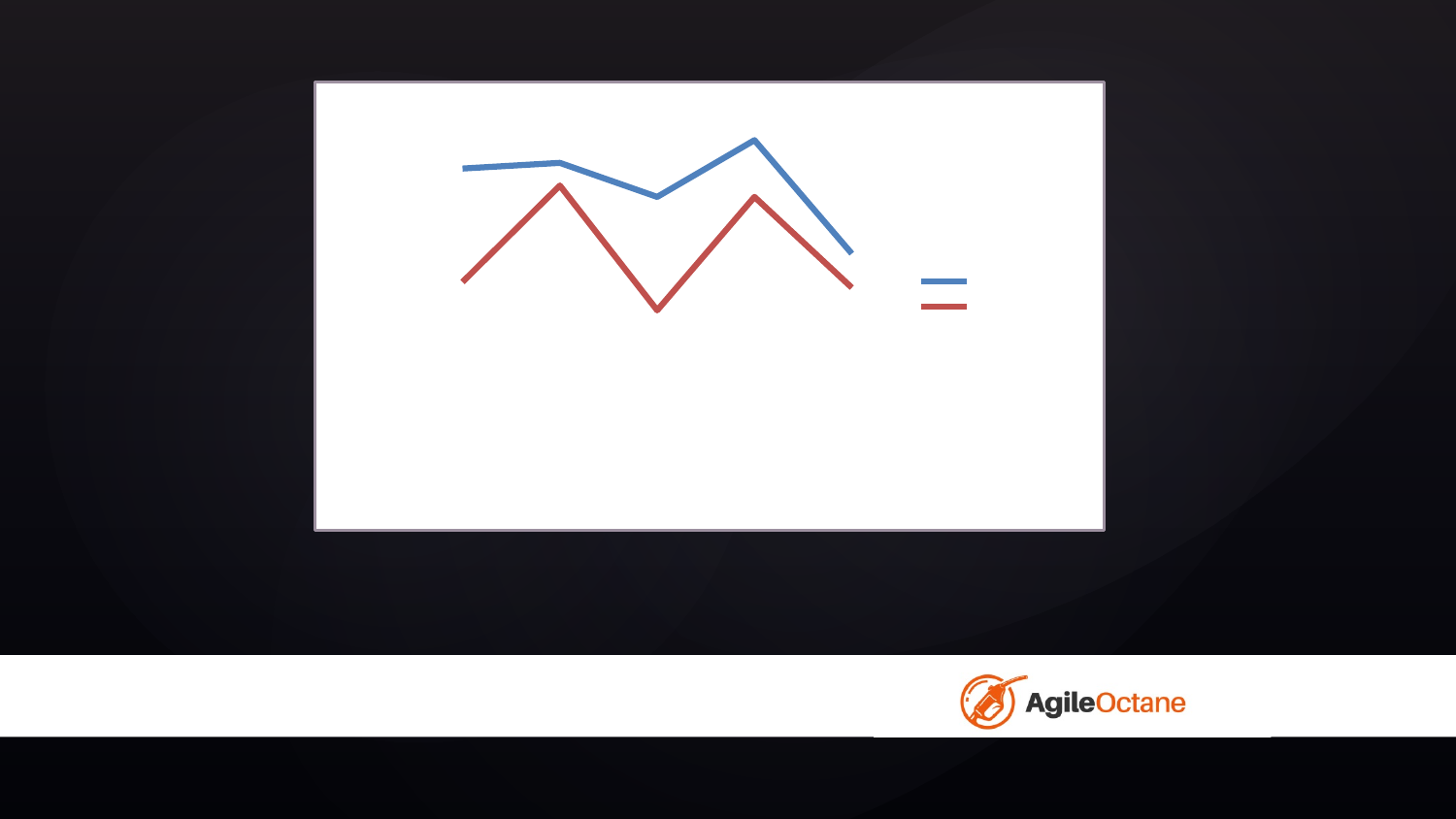
Where is the legend positioned relative to the plotted lines? to the right How many series does the legend list? 2 What kind of chart is shown on the slide? line chart What colours are the two lines in the chart? blue and red Which line is higher at every point, the blue line or the red line? the blue line Does the blue line end higher or lower than where it starts? lower How many data points does each line in the chart have? 5